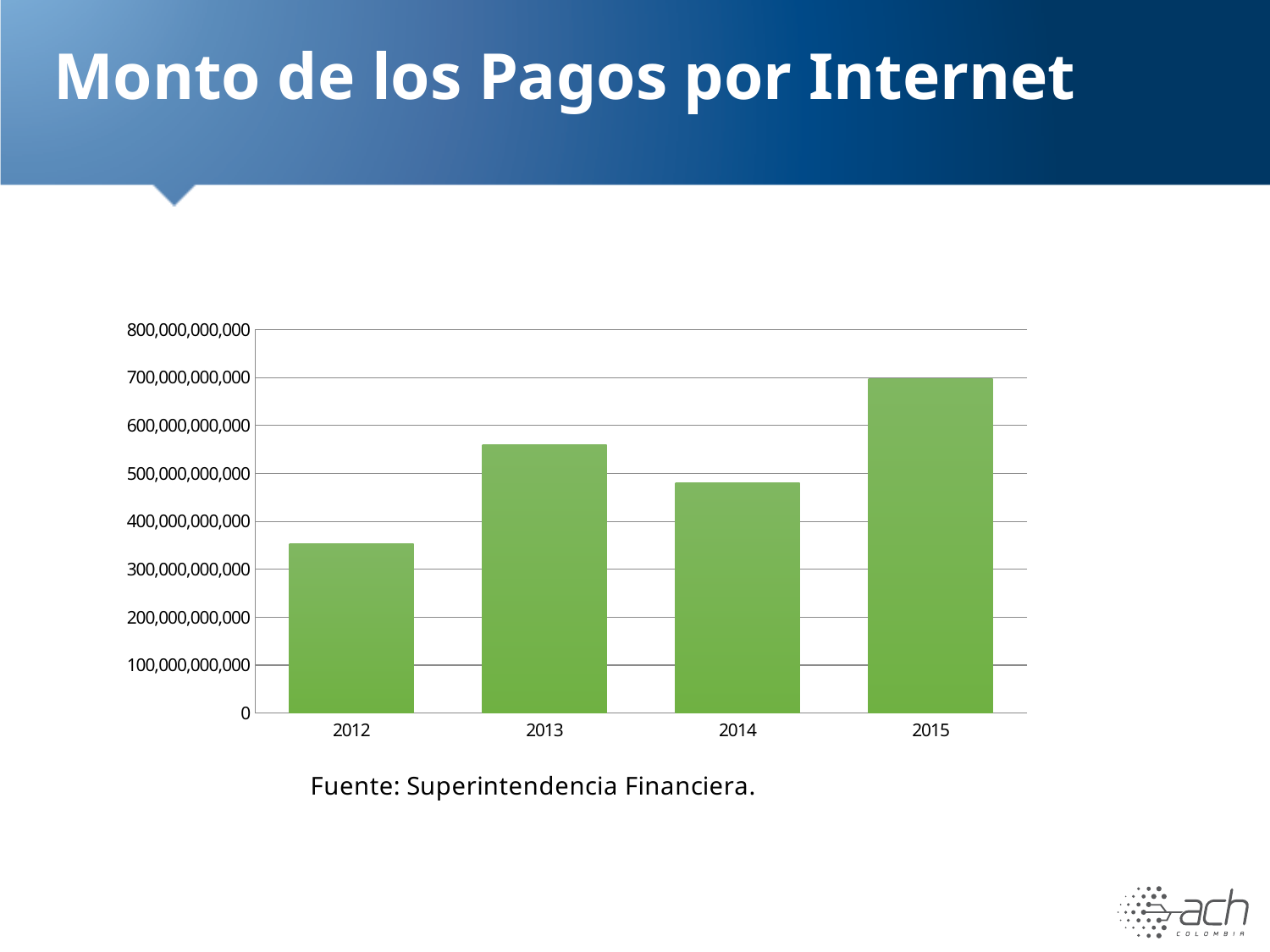
How many years are shown on the x axis of the chart? 4 Did the value rise or fall from 2013 to 2014? fall Is the value for 2012 greater or less than 400,000,000,000? less What is the title of the slide containing the chart? Monto de los Pagos por Internet Which year has the larger value, 2013 or 2014? 2013 Which year has the larger value, 2012 or 2014? 2014 Which year has the lowest value in the chart? 2012 Is the value for 2015 greater or less than 600,000,000,000? greater Which year has the highest value in the chart? 2015 Is the value for 2013 greater or less than 500,000,000,000? greater What kind of chart is shown on the slide? bar chart